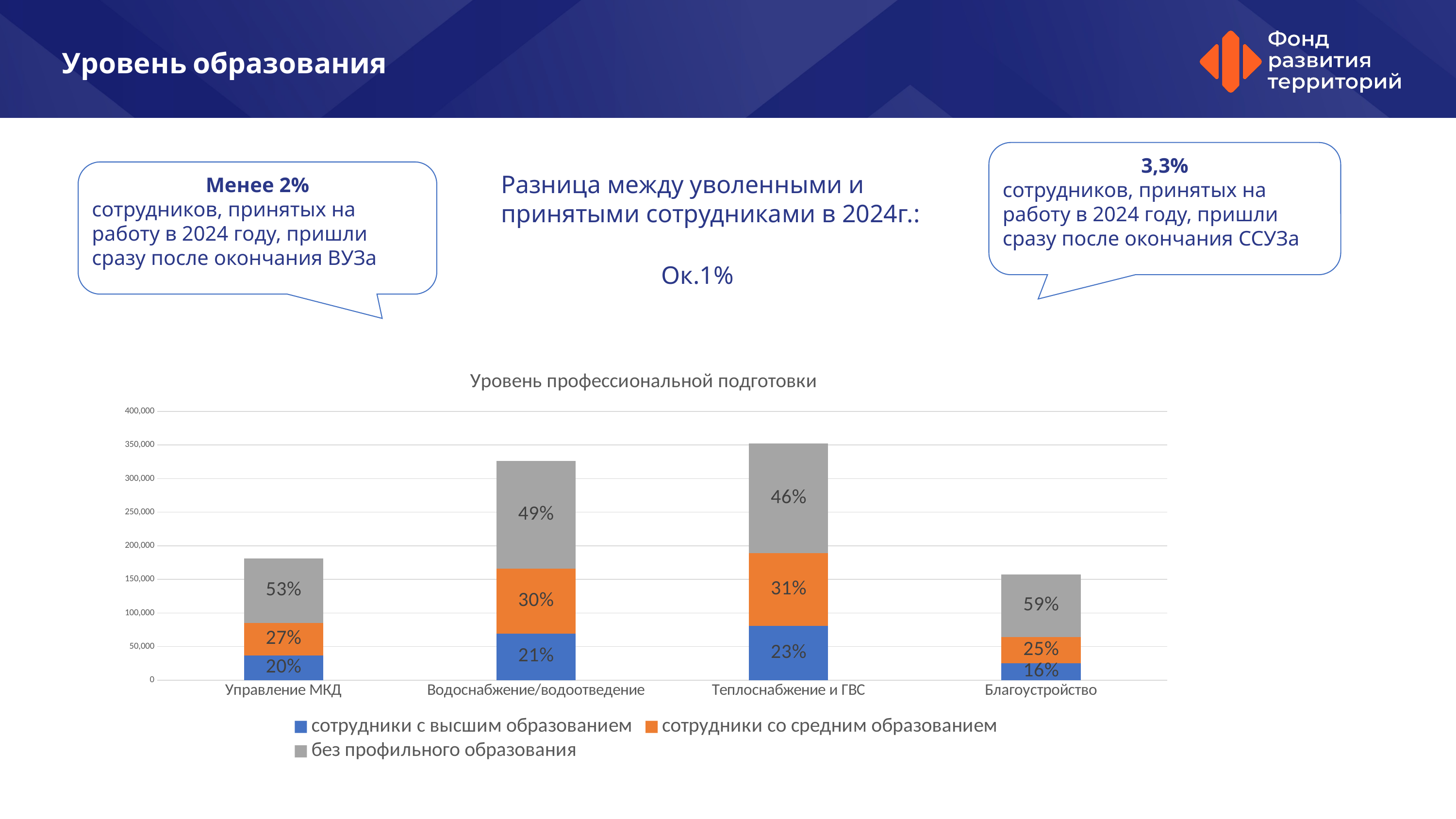
Which category has the tallest stacked bar overall? Теплоснабжение и ГВС Which category has the shortest stacked bar overall? Благоустройство What percentage of employees in Управление МКД have higher education (сотрудники с высшим образованием)? 20% How many categories are shown on the x axis of the chart? 4 Is the total value of the stacked bar for Теплоснабжение и ГВС greater or less than 300,000? greater What type of chart is shown on the slide? stacked bar chart Which category has the highest percentage of employees without specialised education (без профильного образования)? Благоустройство What percentage of employees in Теплоснабжение и ГВС have secondary education (сотрудники со средним образованием)? 31% What is the title of the chart? Уровень профессиональной подготовки What is the share of employees without specialised education (без профильного образования) in Благоустройство? 59% How many series does the chart legend list? 3 What is the difference in percentage points between the share of employees without specialised education in Благоустройство and in Управление МКД? 6